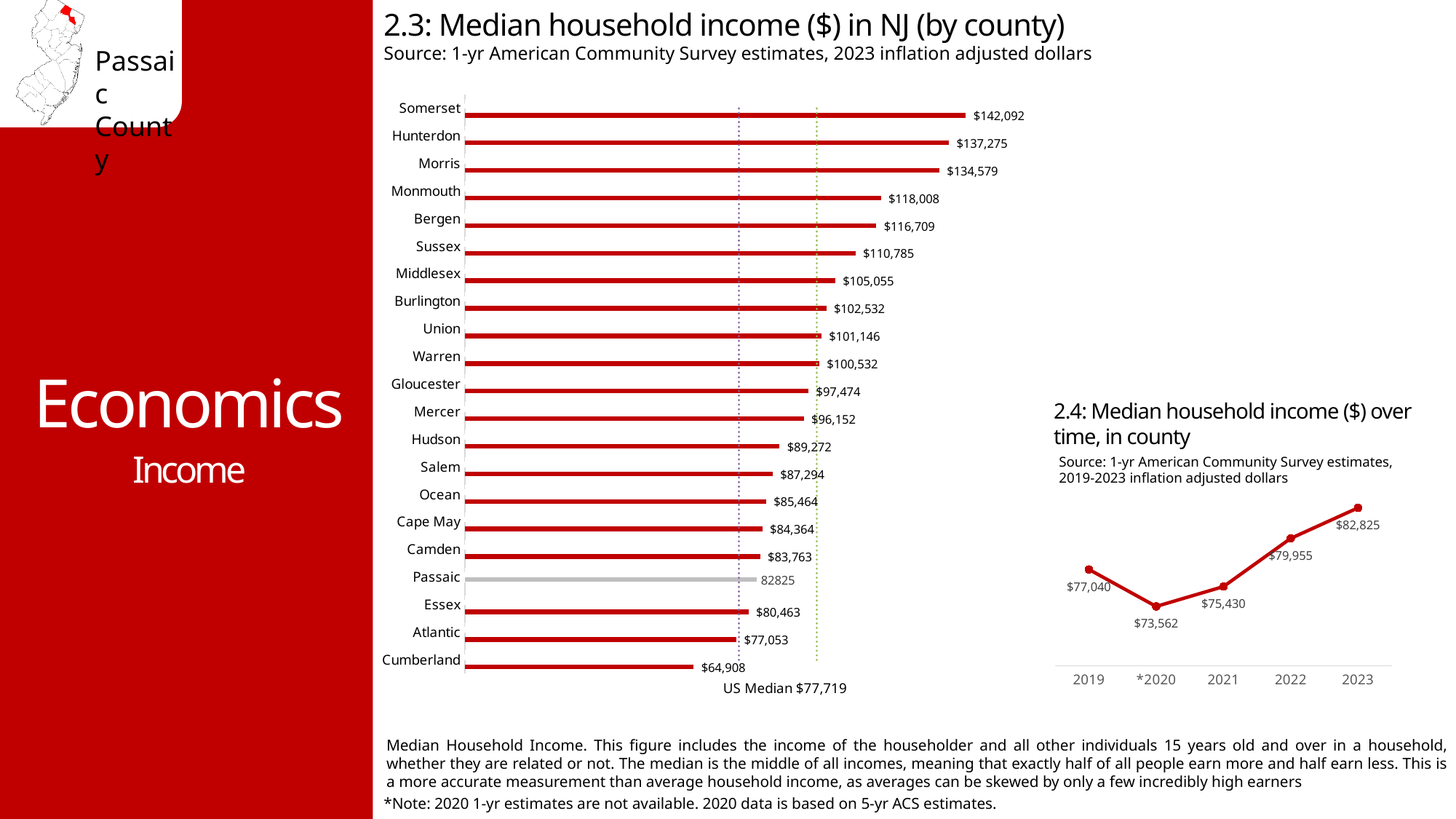
In chart 2.3 (Median household income in NJ by county), what is the median household income for Somerset? $142,092 What kind of chart is chart 2.3 (Median household income in NJ by county)? Bar chart In chart 2.4 (Median household income over time, in county), what is the median household income for 2021? $75,430 In chart 2.3 (Median household income in NJ by county), how many counties are shown? 21 In chart 2.4 (Median household income over time, in county), what is the difference between the 2023 and 2019 values? $5,785 In chart 2.3 (Median household income in NJ by county), which county has a higher median household income, Bergen or Hudson? Bergen In chart 2.3 (Median household income in NJ by county), which county has the lowest median household income? Cumberland In chart 2.4 (Median household income over time, in county), which year has the lowest median household income? *2020 In chart 2.3 (Median household income in NJ by county), what is the median household income for Passaic? 82825 In chart 2.4 (Median household income over time, in county), how many data points are plotted? 5 In chart 2.3 (Median household income in NJ by county), which county has the highest median household income? Somerset In chart 2.3 (Median household income in NJ by county), what is the difference between Somerset's and Cumberland's median household income? $77,184